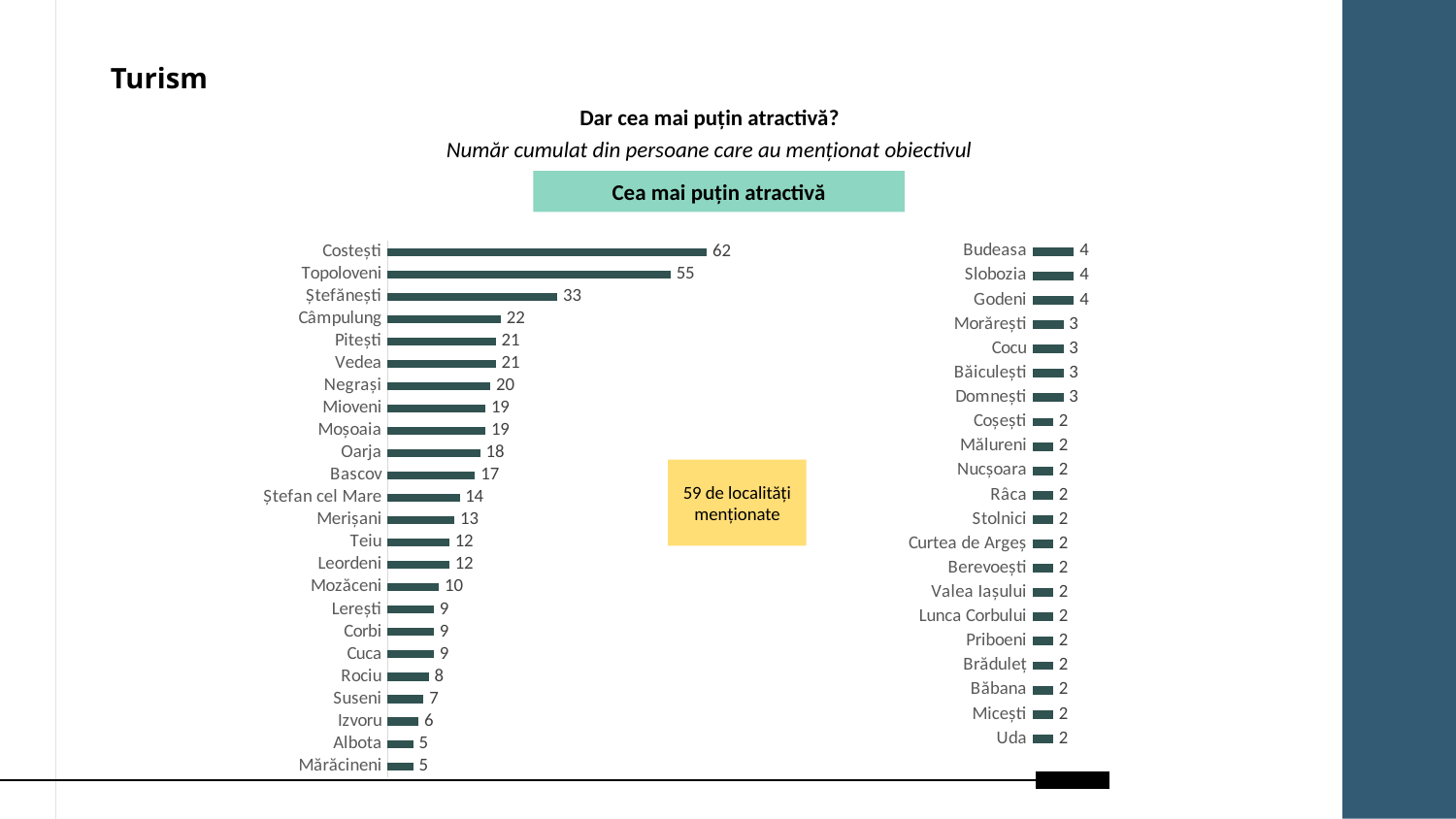
How many localities are listed in the left chart? 24 In the left chart, what is the difference between the values for Costești and Topoloveni? 7 In the right chart, which localities share the highest value? Budeasa, Slobozia, Godeni In the left chart, what is the value for Ștefănești? 33 In the left chart, what is the value for Costești? 62 In the left chart, which is larger, the value for Câmpulung or the value for Negrași? Câmpulung In the left chart, what is the value for Mozăceni? 10 In the left chart, which locality has the highest value? Costești What is the title shown in the green box above the charts? Cea mai puțin atractivă In the right chart, what is the value for Morărești? 3 How many localities are listed in the right chart? 21 What kind of chart is used on this slide? Bar chart